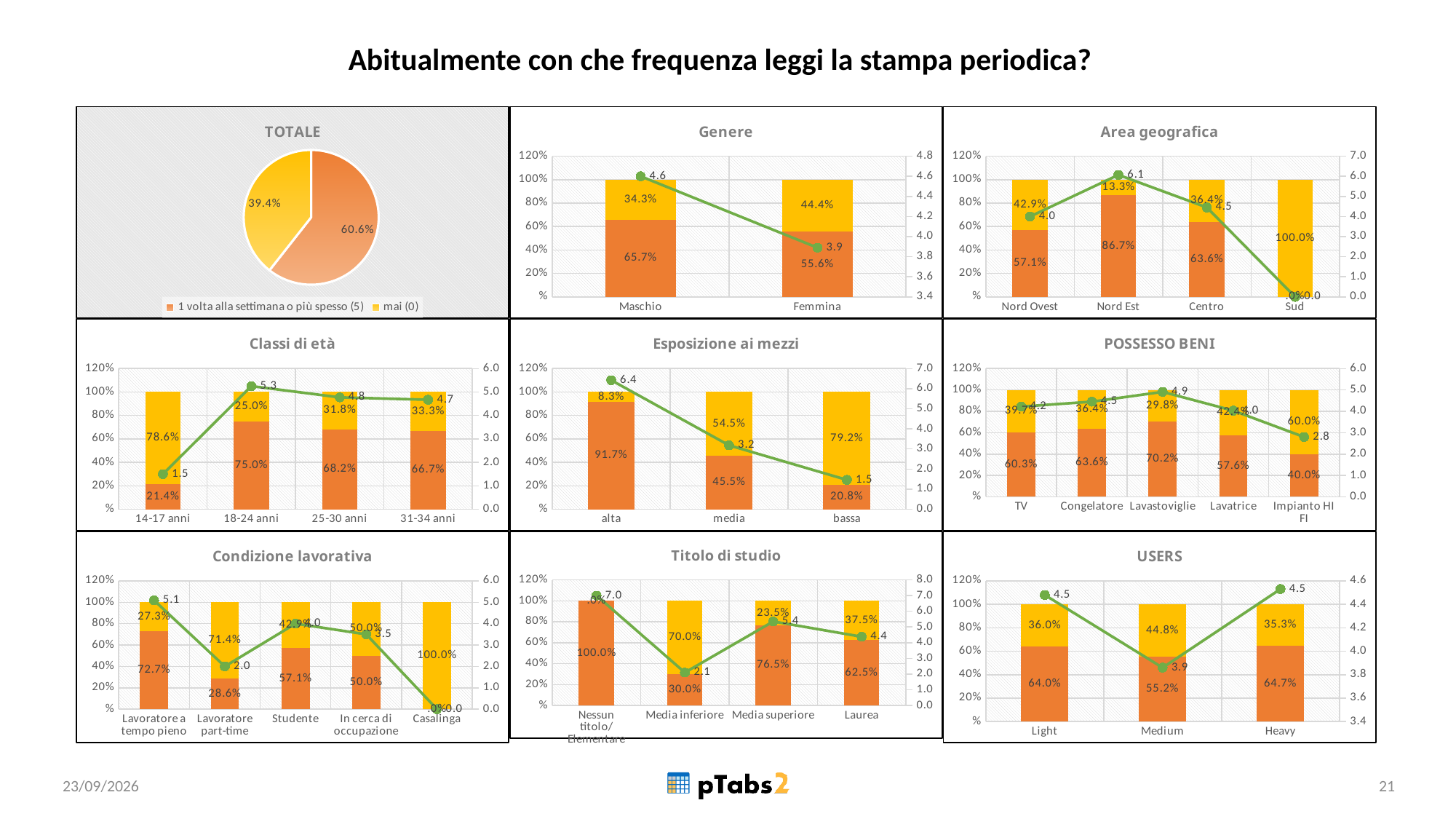
In the Titolo di studio chart, what is the line value for Media inferiore? 2.1 In the Area geografica chart, which category has the highest line value? Nord Est In the POSSESSO BENI chart, how many categories are shown on the x axis? 5 In the Condizione lavorativa chart, which is larger: the orange segment for Lavoratore a tempo pieno or for Studente? Lavoratore a tempo pieno In the USERS chart, what is the orange segment value for Medium? 55.2% What kind of chart is the TOTALE chart? pie chart In the Genere chart, what is the value of the line marker for Femmina? 3.9 In the Classi di età chart, which age class has the lowest line value? 14-17 anni In the Esposizione ai mezzi chart, what is the yellow segment value for bassa? 79.2% In the Area geografica chart, what percentage is shown for the orange segment of Nord Ovest? 57.1% In the Genere chart, what is the difference between the orange segment for Maschio and the orange segment for Femmina? 10.1% In the TOTALE pie chart, what share is shown for the slice labelled '1 volta alla settimana o più spesso (5)'? 60.6%